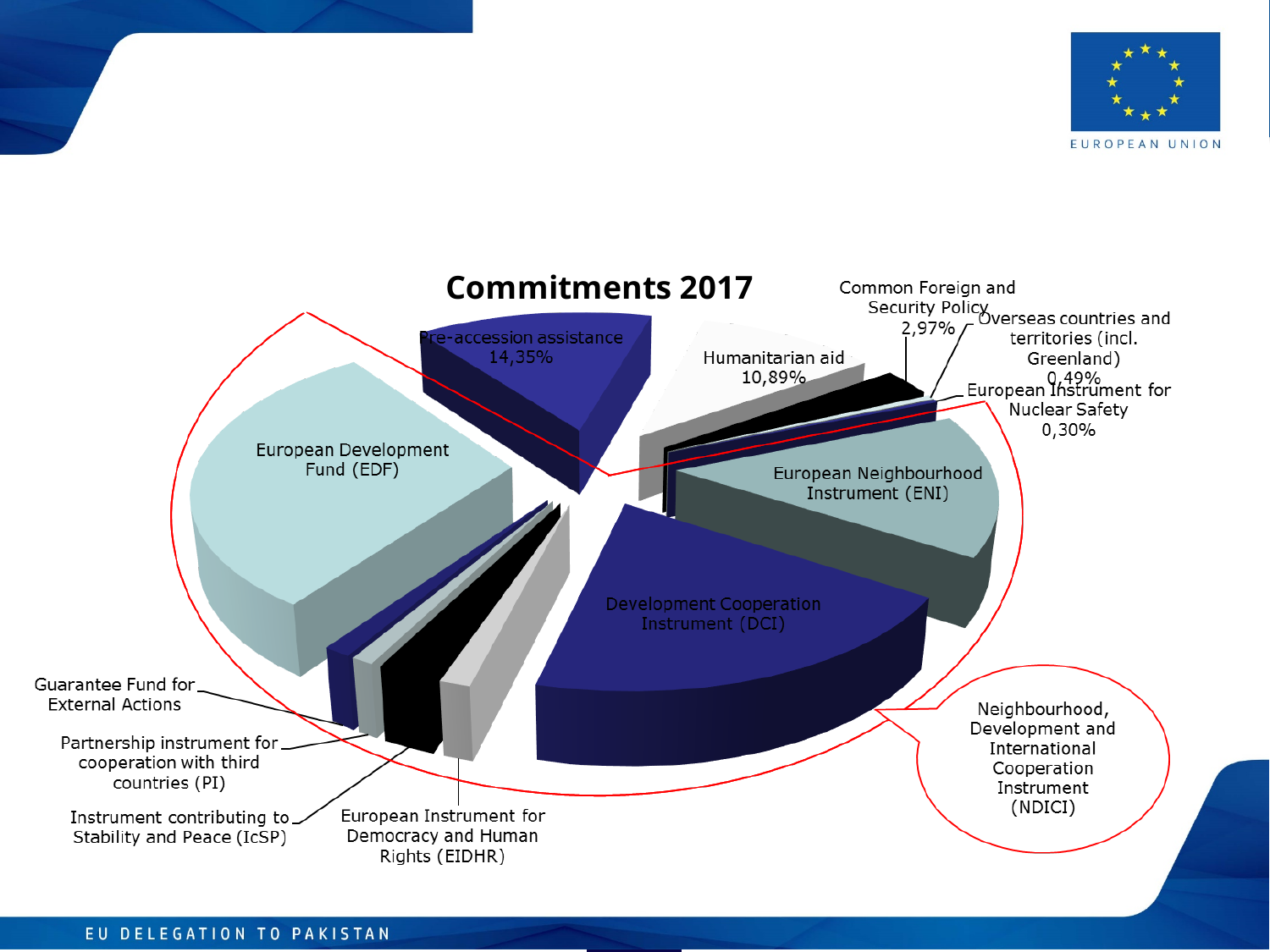
What is the difference between the shares for Pre-accession assistance and Humanitarian aid? 3,46% What share is shown for the European Instrument for Nuclear Safety? 0,30% What is the difference between the shares for Common Foreign and Security Policy and Overseas countries and territories (incl. Greenland)? 2,48% Which slice is the largest in the pie chart? Development Cooperation Instrument (DCI) Which is larger, the share for Pre-accession assistance or for Humanitarian aid? Pre-accession assistance What share of commitments does Humanitarian aid have? 10,89% What is the title of the chart? Commitments 2017 What share is shown for Overseas countries and territories (incl. Greenland)? 0,49% What share of commitments does Pre-accession assistance have? 14,35% What share is shown for Common Foreign and Security Policy? 2,97% How many slices does the pie chart have? 12 What kind of chart is shown on the slide? pie chart